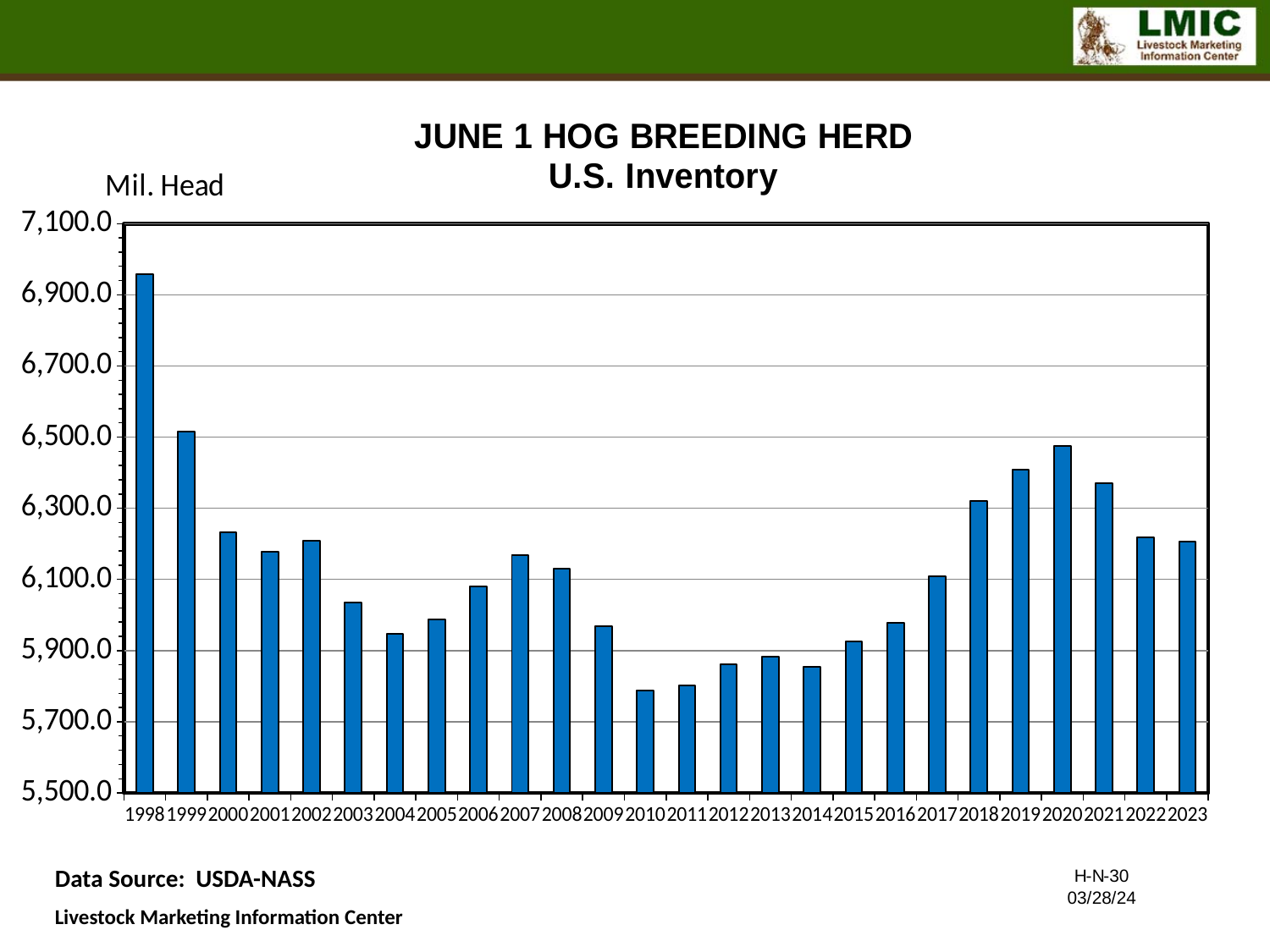
Which is larger, the value for 2006 or the value for 2007? 2007 What unit is shown on the y axis of the chart? Mil. Head Is the value for 1998 greater or less than 6,700.0? greater Do the values generally rise or fall from 2010 to 2020? rise Which year has the highest June 1 hog breeding herd inventory? 1998 Is the value for 2020 greater or less than 6,300.0? greater Which is larger, the value for 2019 or the value for 2020? 2020 What kind of chart is shown on the slide? bar chart How many years are plotted on the x axis? 26 Is the value for 2003 greater or less than 6,100.0? less